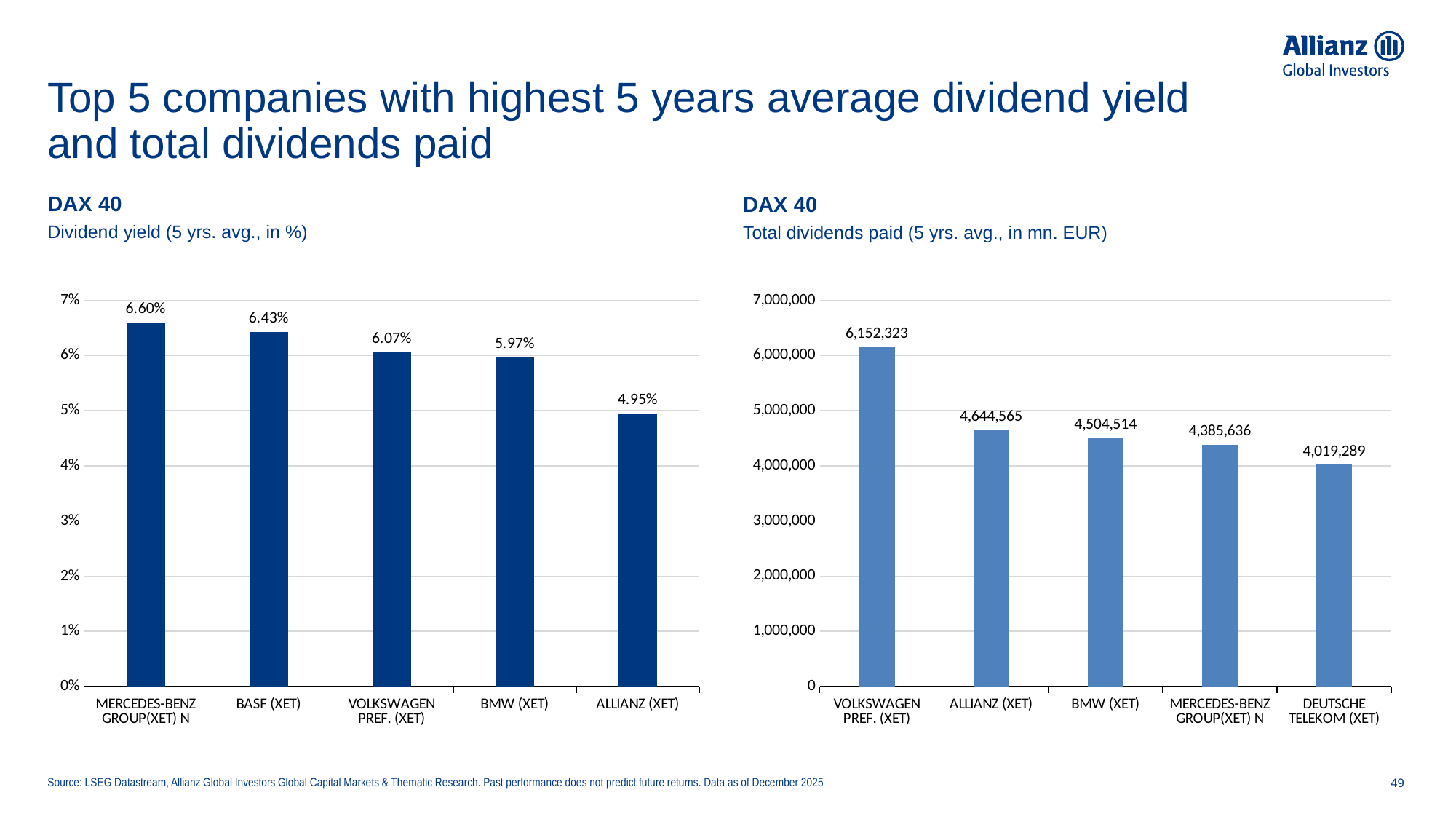
In the right chart (Total dividends paid), which company has the lowest value? DEUTSCHE TELEKOM (XET) In the right chart (Total dividends paid), which company has the highest value? VOLKSWAGEN PREF. (XET) In the left chart (Dividend yield), how many companies are shown? 5 What kind of chart is the right chart (Total dividends paid)? bar chart In the right chart (Total dividends paid), which is larger, the value for ALLIANZ (XET) or the value for MERCEDES-BENZ GROUP(XET) N? ALLIANZ (XET) In the left chart (Dividend yield, 5 yrs. avg., in %), what is the value for BASF (XET)? 6.43% In the left chart (Dividend yield), do the values rise or fall from left to right? fall In the right chart (Total dividends paid), is the value for VOLKSWAGEN PREF. (XET) greater or less than 6,000,000? greater In the left chart (Dividend yield), which company has the highest dividend yield? MERCEDES-BENZ GROUP(XET) N In the left chart (Dividend yield), which company has the lowest dividend yield? ALLIANZ (XET) In the right chart (Total dividends paid, 5 yrs. avg., in mn. EUR), what is the value for BMW (XET)? 4,504,514 In the left chart (Dividend yield), what is the difference between the values for MERCEDES-BENZ GROUP(XET) N and ALLIANZ (XET)? 1.65%